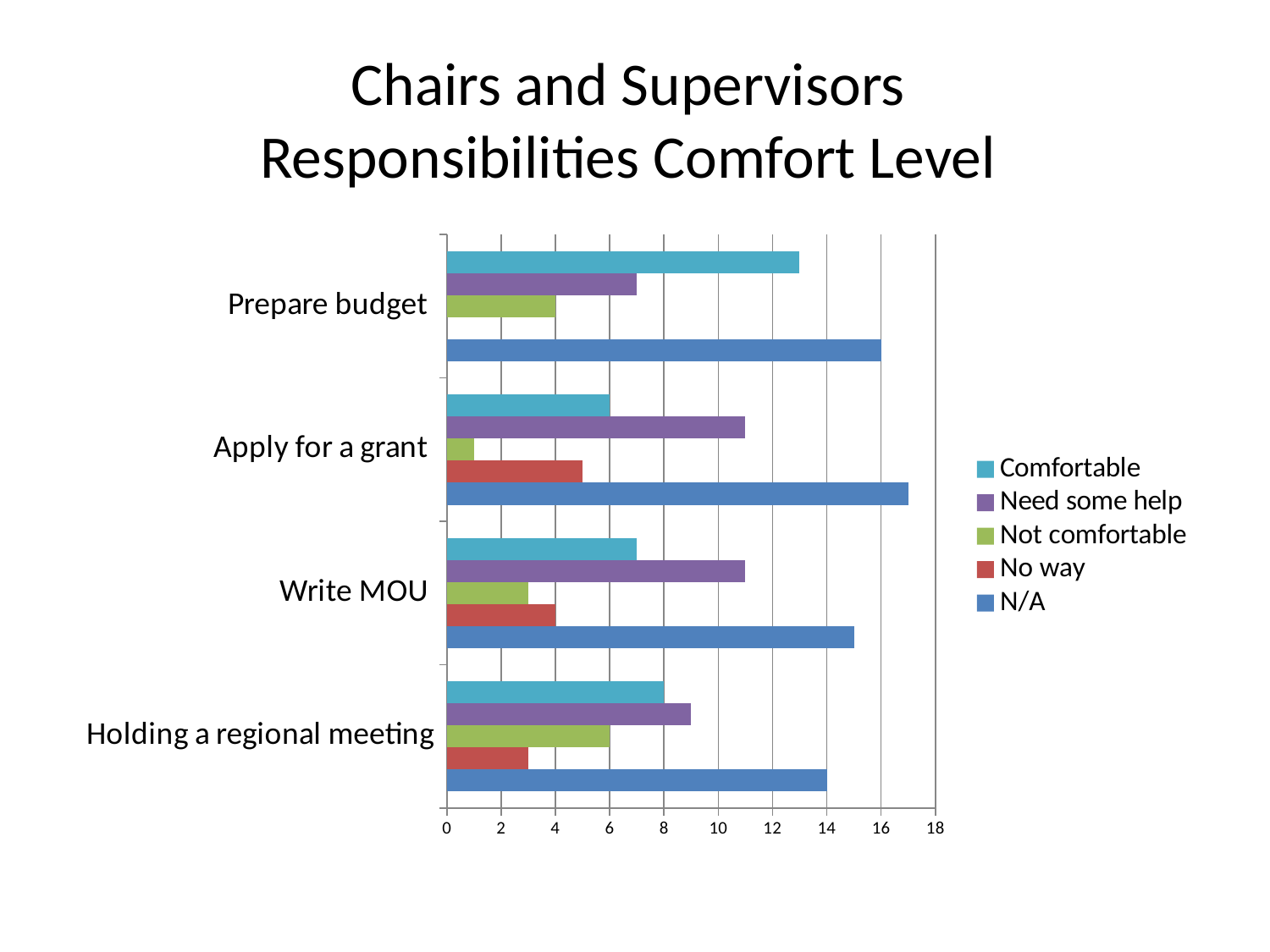
What is the Comfortable value for Holding a regional meeting? 8 Is the Comfortable value for Prepare budget greater or less than 12? greater What is the N/A value for Holding a regional meeting? 14 Which category has the highest Comfortable value? Prepare budget How many responsibility categories are shown on the chart? 4 Which is larger for Write MOU, the Need some help value or the Comfortable value? Need some help What kind of chart is shown on the slide? bar chart What is the N/A value for Prepare budget? 16 What is the Not comfortable value for Prepare budget? 4 Is the Not comfortable value for Apply for a grant greater or less than 2? less Which category has the highest N/A value? Apply for a grant How many series does the legend list? 5